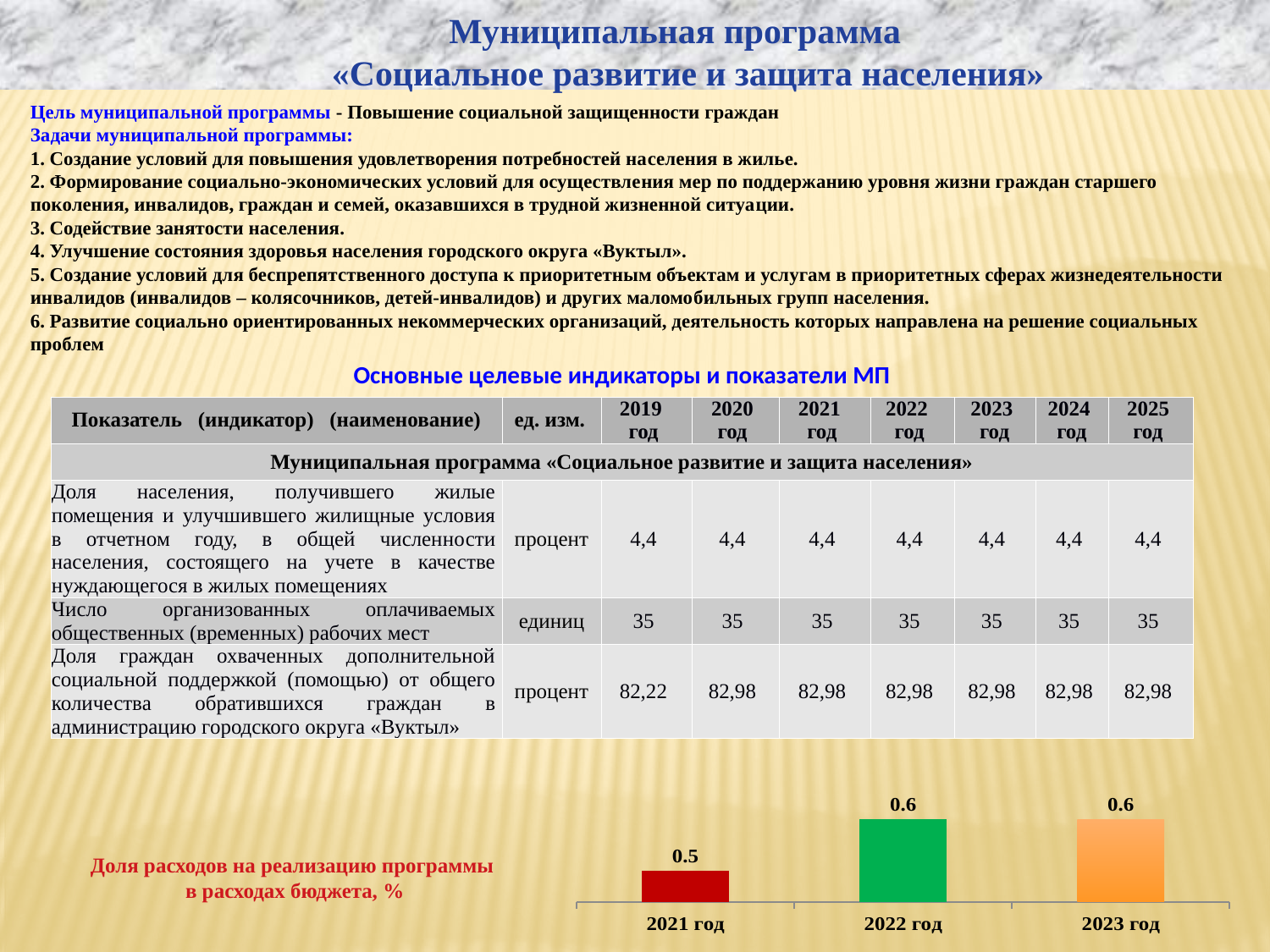
What is the value for 2023 год in the bar chart? 0.6 What is the title of the bar chart at the bottom of the slide? Доля расходов на реализацию программы в расходах бюджета, % What is the difference between the values for 2022 год and 2021 год in the bar chart? 0.1 Which is larger in the bar chart, the value for 2021 год or the value for 2022 год? 2022 год How many bars are shown in the chart at the bottom of the slide? 3 What colour is the bar for 2021 год in the chart? Red What is the value for 2022 год in the bar chart? 0.6 What is the value for 2021 год in the bar chart at the bottom of the slide? 0.5 Which year has the lowest value in the bar chart? 2021 год Do the values in the bar chart rise or fall from 2021 год to 2023 год? Rise What kind of chart is shown at the bottom of the slide? Bar chart